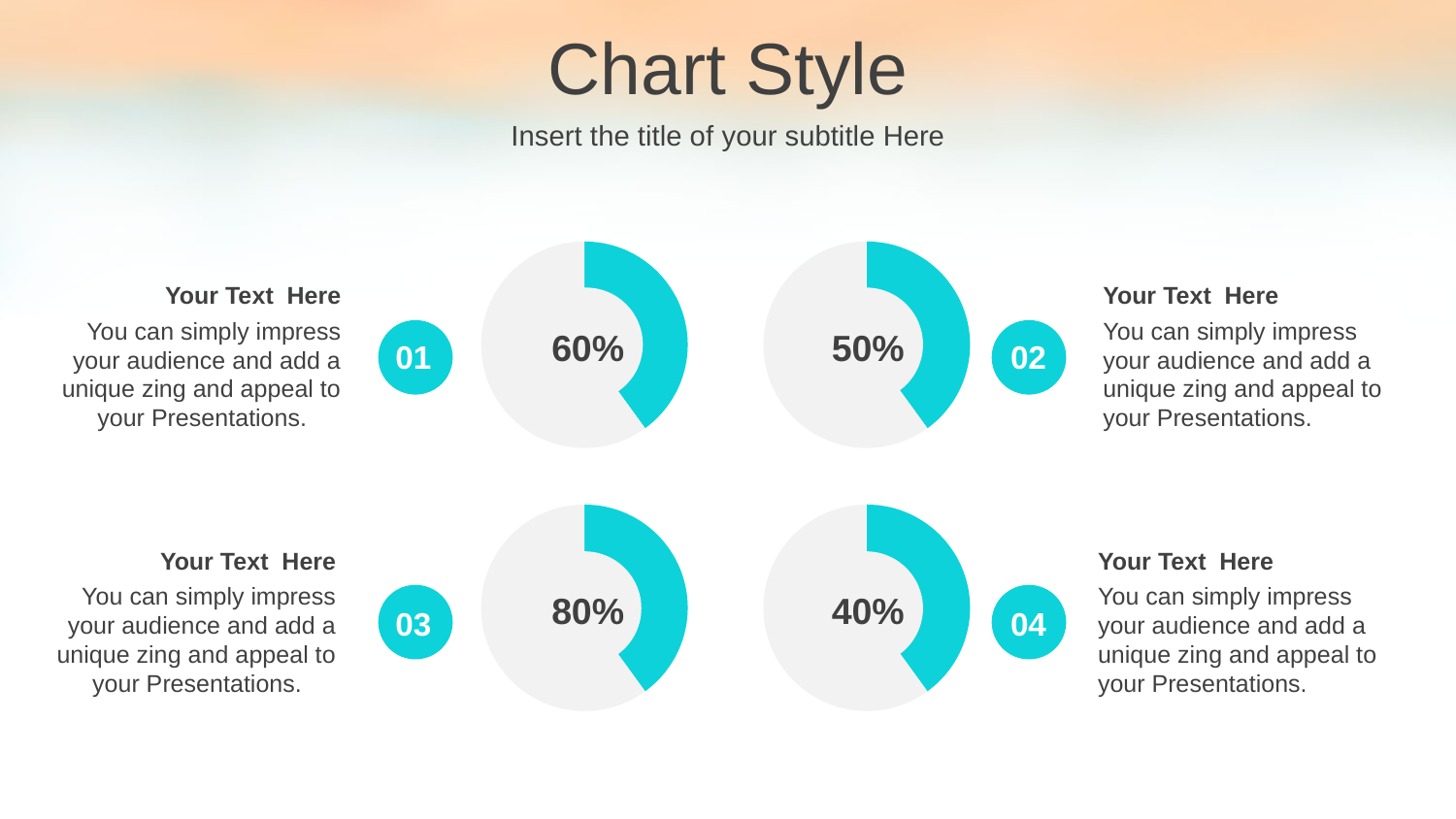
What kind of chart is used for each of the four figures on the slide? Donut chart Which of the four donut charts shows the highest percentage? 03 (80%) What percentage is shown in the donut chart next to label 04 (bottom right)? 40% What is the difference between the percentage in chart 01 and the percentage in chart 02? 10% What percentage is shown in the donut chart next to label 01 (top left)? 60% What is the title of the slide containing the four donut charts? Chart Style What is the difference between the percentage in chart 03 and the percentage in chart 04? 40% How many donut charts are on the slide? 4 What percentage is shown in the donut chart next to label 03 (bottom left)? 80% Which shows a larger percentage, chart 01 or chart 02? Chart 01 What percentage is shown in the donut chart next to label 02 (top right)? 50% Which of the four donut charts shows the lowest percentage? 04 (40%)